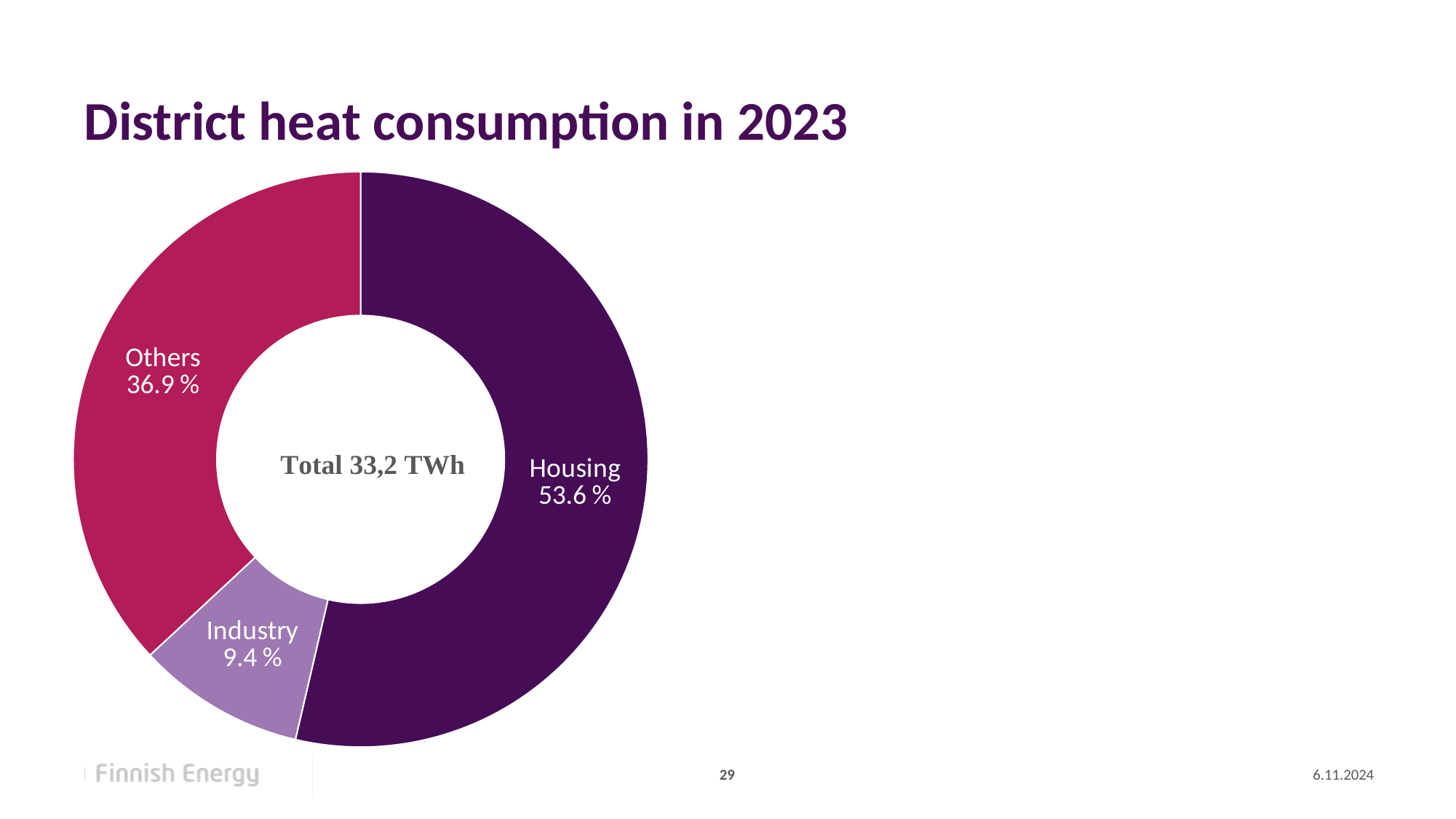
What share of district heat consumption in 2023 is attributed to Housing? 53.6 % Which category has the largest share of district heat consumption in 2023? Housing What share of district heat consumption in 2023 is attributed to Others? 36.9 % What share of district heat consumption in 2023 is attributed to Industry? 9.4 % What is the difference in percentage points between the Housing share and the Others share? 16.7 What is the title of the slide? District heat consumption in 2023 What is the difference in percentage points between the Others share and the Industry share? 27.5 Which is larger, the share for Others or the share for Industry? Others Which category has the smallest share of district heat consumption in 2023? Industry What kind of chart is shown on the slide? Pie chart (doughnut) What total district heat consumption is shown in the centre of the chart? Total 33,2 TWh How many categories are shown in the chart? 3